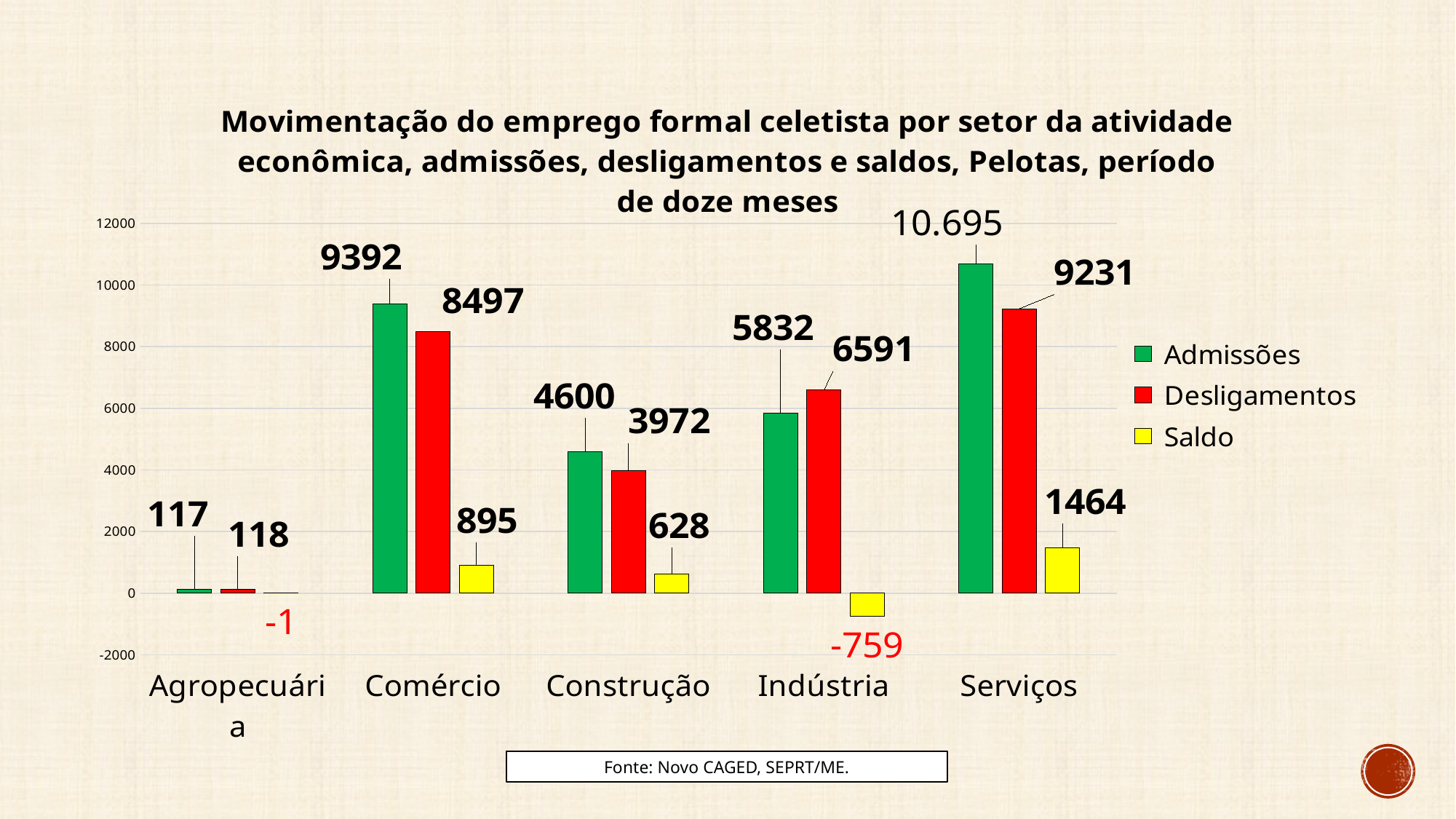
How many series does the legend list? 3 What is the difference between Admissões and Desligamentos for Construção? 628 What is the Admissões value for Comércio? 9392 Which sector has the highest Admissões value? Serviços What is the Saldo value for Indústria? -759 What kind of chart is shown on the slide? Bar chart What is the difference between Desligamentos and Admissões for Indústria? 759 Which sector has the lowest Saldo value? Indústria What is the Desligamentos value for Indústria? 6591 How many sectors are shown on the x axis? 5 For Indústria, which is larger: Admissões or Desligamentos? Desligamentos What is the Saldo value for Serviços? 1464